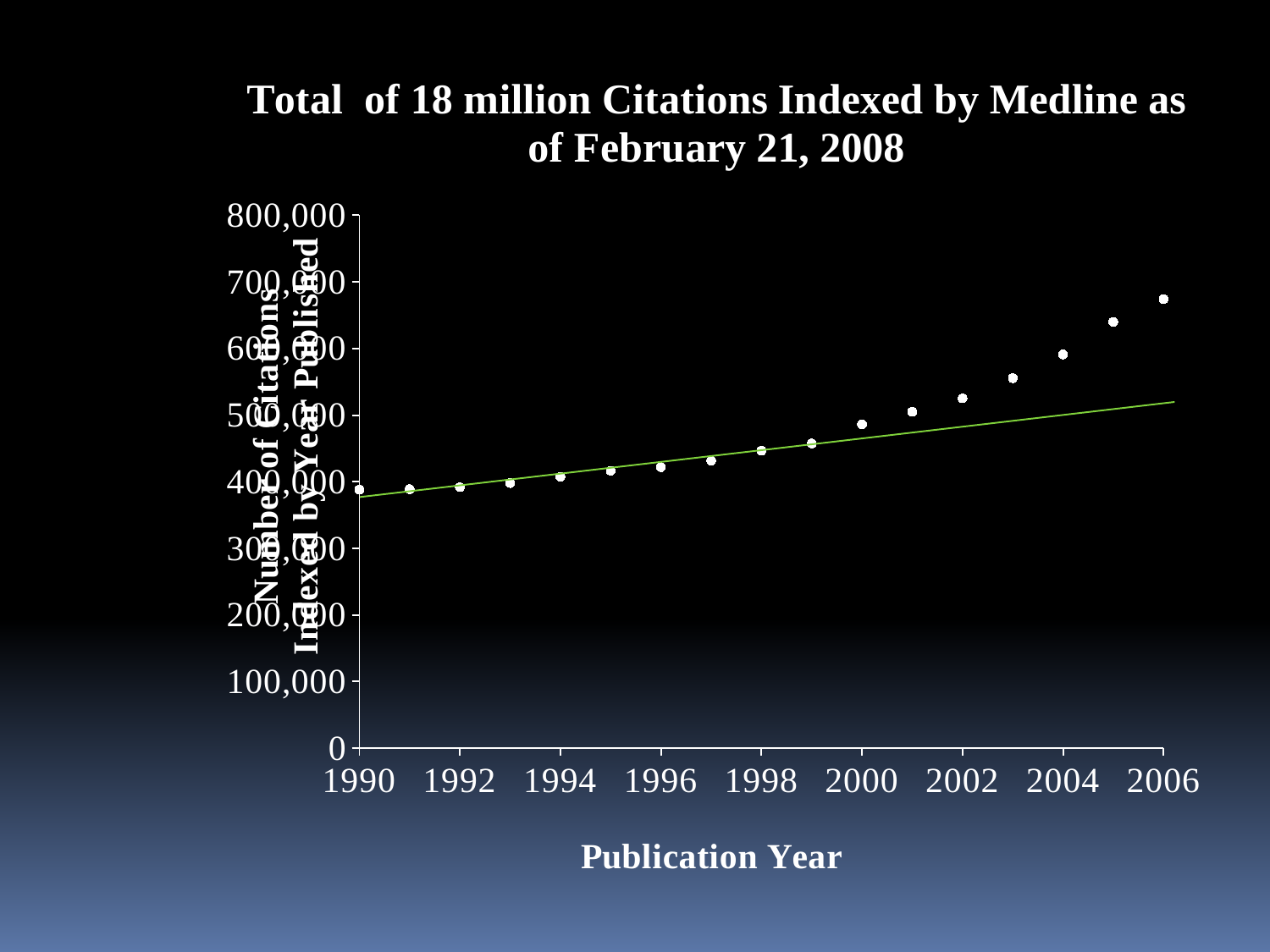
What is the label of the x axis? Publication Year Which has the larger number of citations, 1992 or 2002? 2002 Which publication year has the highest number of citations? 2006 Which publication year has the lowest number of citations? 1990 Is the value for 2004 greater or less than 500,000? greater What is the title of the chart? Total of 18 million Citations Indexed by Medline as of February 21, 2008 Is the value for 2006 greater or less than 600,000? greater How many data points are plotted on the chart? 17 Do the plotted values rise or fall as the publication year increases from 1990 to 2006? rise Is the value for 1996 greater or less than 300,000? greater What kind of chart is shown on the slide? scatter chart